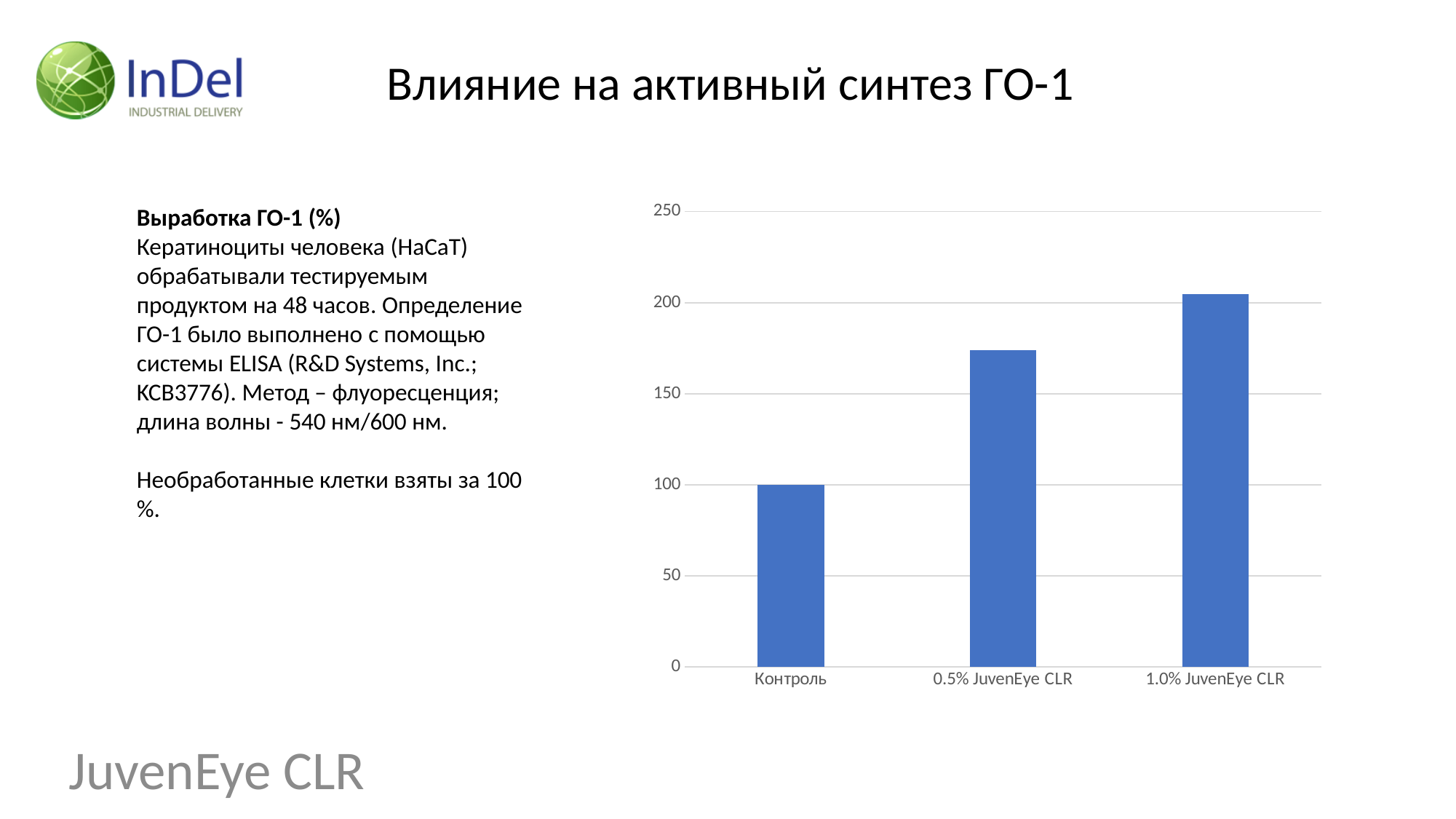
How many bars (categories) does the chart show? 3 Is the value for 0.5% JuvenEye CLR greater or less than 200? less Is the value for 0.5% JuvenEye CLR greater or less than 150? greater Which is larger, the value for 0.5% JuvenEye CLR or the value for 1.0% JuvenEye CLR? 1.0% JuvenEye CLR Which category has the lowest value? Контроль Which category has the highest value? 1.0% JuvenEye CLR What is the value for Контроль? 100 Is the value for 1.0% JuvenEye CLR greater or less than 250? less What is the maximum value shown on the vertical axis? 250 What kind of chart is shown on the slide? bar chart Do the values rise or fall from left to right across the categories? rise